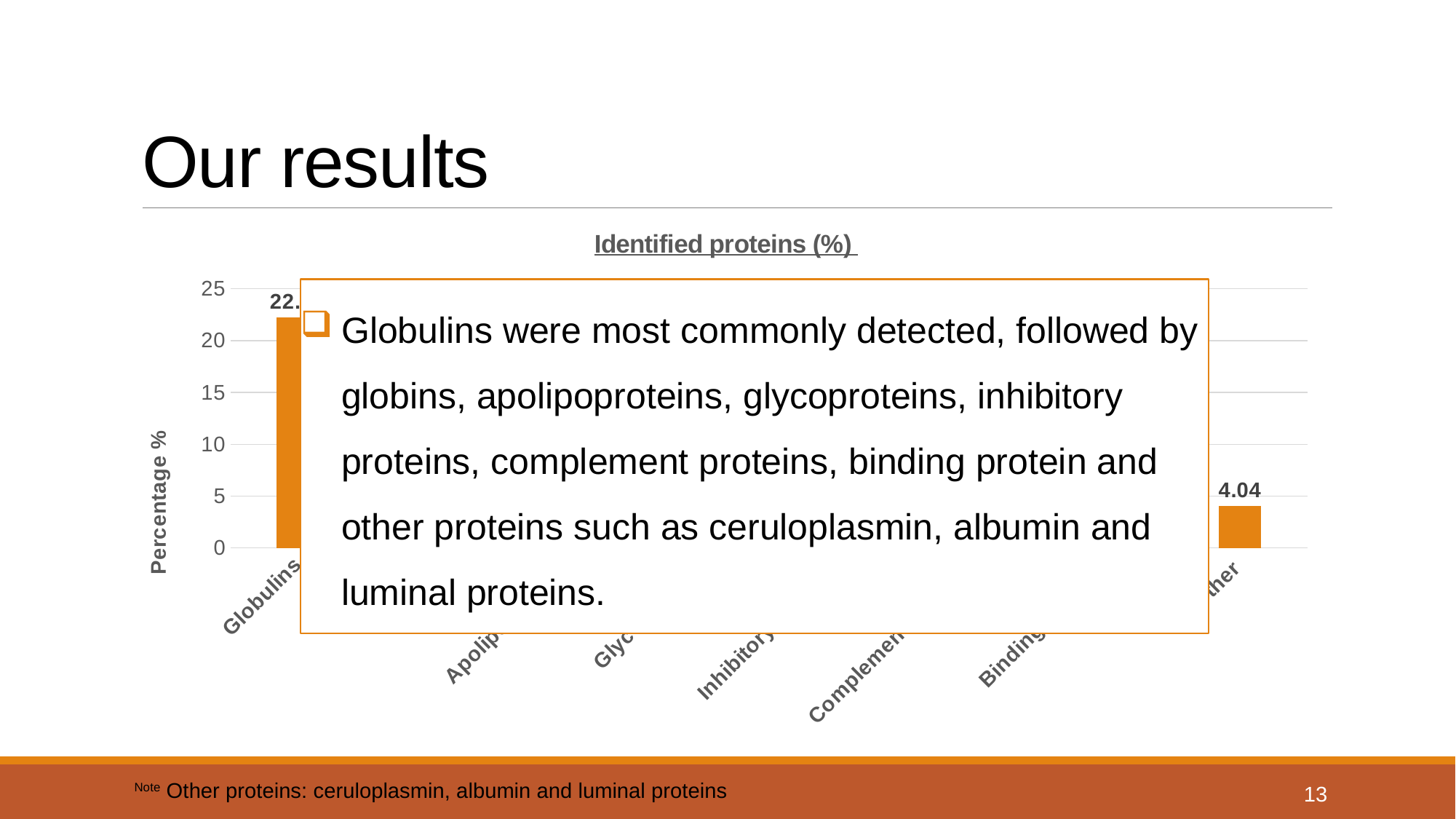
What is the label on the vertical axis of the chart? Percentage % Is the value of the rightmost bar greater or less than 5? less What is the title of the chart? Identified proteins (%) Which category has the highest value in the chart? Globulins Which is larger, the value for Globulins or the value of the rightmost bar? Globulins Is the value for Globulins greater or less than 20? greater What kind of chart is shown on the slide? bar chart What value is printed on the rightmost bar of the chart? 4.04 What is the highest tick value shown on the vertical axis? 25